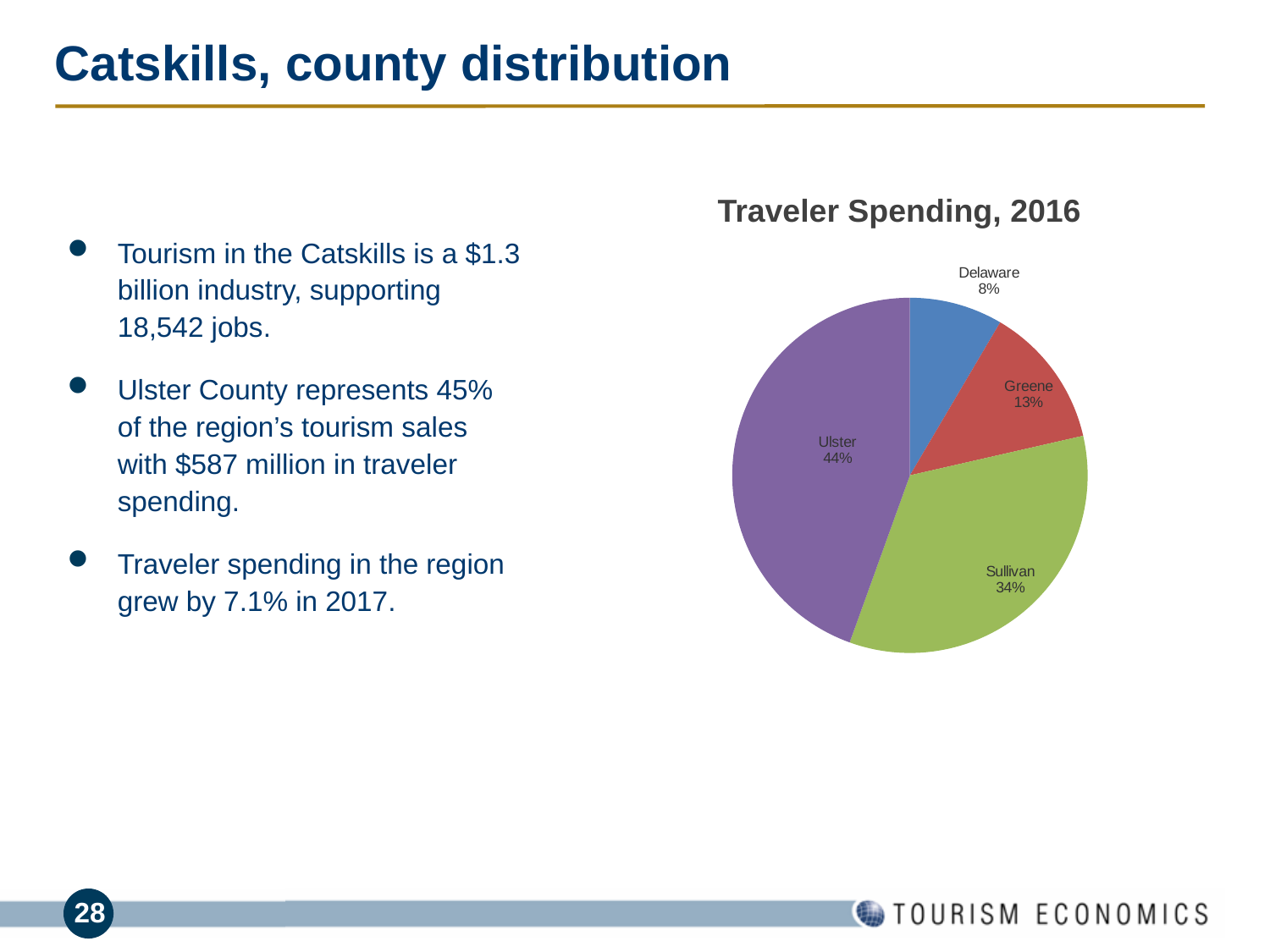
What is the difference in percentage points between Greene's and Delaware's shares? 5 Which has a larger share of traveler spending, Greene or Sullivan? Sullivan Which county has the largest slice of the pie chart? Ulster What kind of chart is shown on the slide? Pie chart What is the title of the chart? Traveler Spending, 2016 What is the difference in percentage points between Ulster's and Sullivan's shares? 10 What share of traveler spending does Sullivan have in the pie chart? 34% What share of traveler spending does Ulster have in the pie chart? 44% What share of traveler spending does Greene have in the pie chart? 13% Which county has the smallest slice of the pie chart? Delaware How many counties are shown in the pie chart? 4